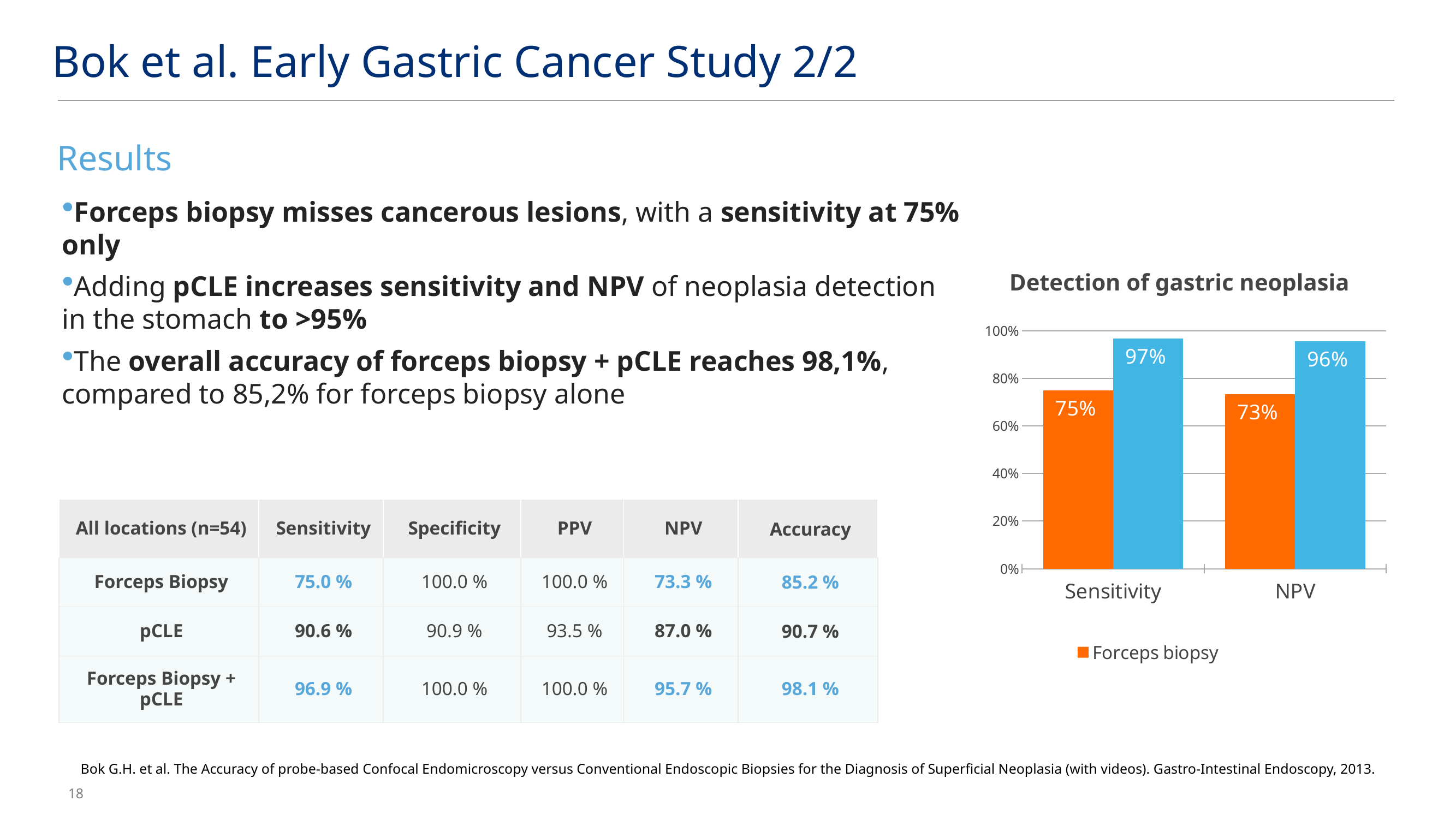
What kind of chart is 'Detection of gastric neoplasia'? bar chart In the 'Detection of gastric neoplasia' chart, what is the Sensitivity value for Forceps biopsy? 75% In the 'Detection of gastric neoplasia' chart, for NPV, which is larger: the Forceps biopsy bar or the blue bar? the blue bar In the 'Detection of gastric neoplasia' chart, what is the NPV value for Forceps biopsy? 73% In the 'Detection of gastric neoplasia' chart, what is the difference between the blue bar and the Forceps biopsy bar for Sensitivity? 22% In the 'Detection of gastric neoplasia' chart, what value is shown on the blue bar for Sensitivity? 97% How many categories are shown on the x axis of the 'Detection of gastric neoplasia' chart? 2 What colour are the Forceps biopsy bars in the 'Detection of gastric neoplasia' chart? orange In the 'Detection of gastric neoplasia' chart, which category has the higher Forceps biopsy value? Sensitivity In the 'Detection of gastric neoplasia' chart, is the Forceps biopsy value for NPV greater or less than 80%? less In the 'Detection of gastric neoplasia' chart, what is the difference between the blue bar and the Forceps biopsy bar for NPV? 23% In the 'Detection of gastric neoplasia' chart, what value is shown on the blue bar for NPV? 96%